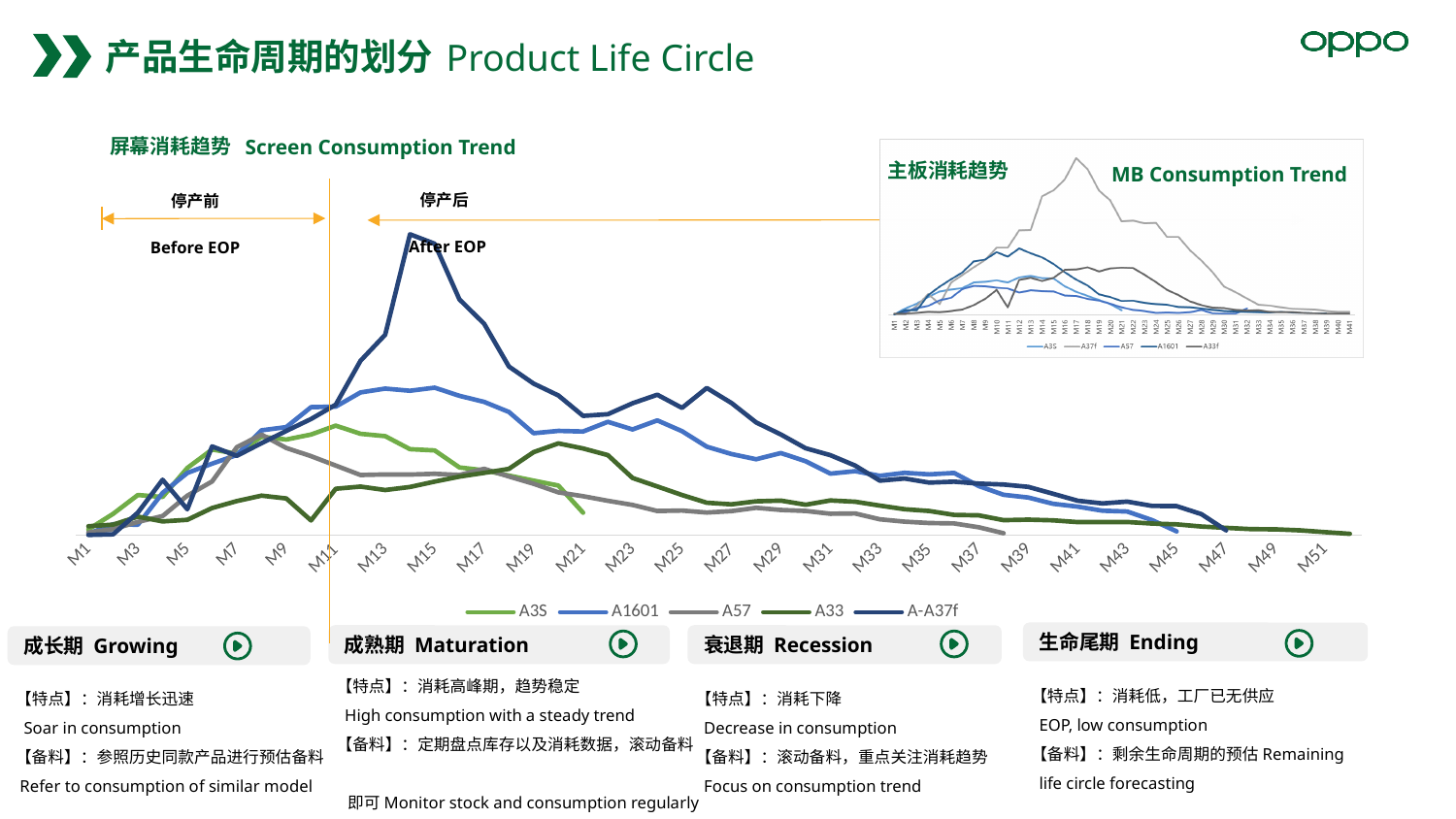
In the Screen Consumption Trend chart, which series stops earliest along the x axis? A3S In the Screen Consumption Trend chart, at M13, which series is higher: A-A37f or A57? A-A37f How many series does the legend of the Screen Consumption Trend chart list? 5 In the Screen Consumption Trend chart, does the A33 series rise or fall between M11 and M19? rise In the Screen Consumption Trend chart, which series reaches the highest peak? A-A37f In the MB Consumption Trend chart, which series reaches the highest peak? A37f What kind of chart is the MB Consumption Trend chart? line chart In the Screen Consumption Trend chart, does the A-A37f series rise or fall between M13 and M21? fall How many series does the legend of the MB Consumption Trend chart list? 5 What kind of chart is the Screen Consumption Trend chart? line chart What is the last x-axis label shown on the Screen Consumption Trend chart? M51 In the Screen Consumption Trend chart, at M19, which series is higher: A1601 or A3S? A1601